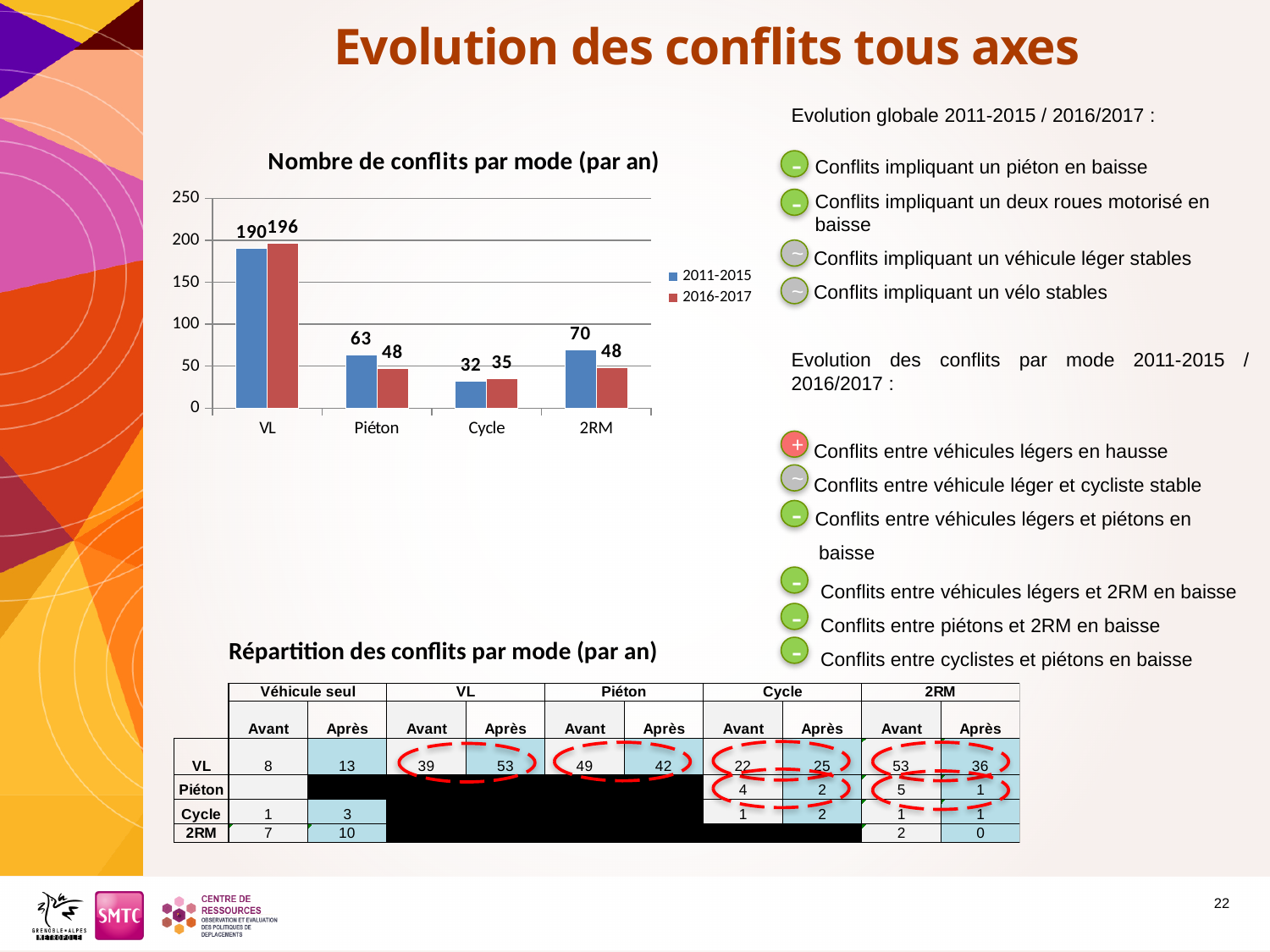
In the chart 'Nombre de conflits par mode (par an)', what is the value for Piéton in the 2016-2017 series? 48 In the chart 'Nombre de conflits par mode (par an)', what is the value for VL in the 2011-2015 series? 190 In the chart 'Nombre de conflits par mode (par an)', what is the value for 2RM in the 2016-2017 series? 48 In the chart 'Nombre de conflits par mode (par an)', which category has the highest value in the 2011-2015 series? VL In the chart 'Nombre de conflits par mode (par an)', what is the difference between the 2011-2015 and 2016-2017 values for 2RM? 22 How many categories are shown on the x axis of the chart 'Nombre de conflits par mode (par an)'? 4 In the chart 'Nombre de conflits par mode (par an)', which is larger for Piéton: the 2011-2015 value or the 2016-2017 value? 2011-2015 In the chart 'Nombre de conflits par mode (par an)', what is the value for Cycle in the 2011-2015 series? 32 In the chart 'Nombre de conflits par mode (par an)', which category has the lowest value in the 2016-2017 series? Cycle How many series does the legend of the chart 'Nombre de conflits par mode (par an)' list? 2 What kind of chart is 'Nombre de conflits par mode (par an)'? Bar chart In the chart 'Nombre de conflits par mode (par an)', is the 2016-2017 value for VL greater or less than 150? greater